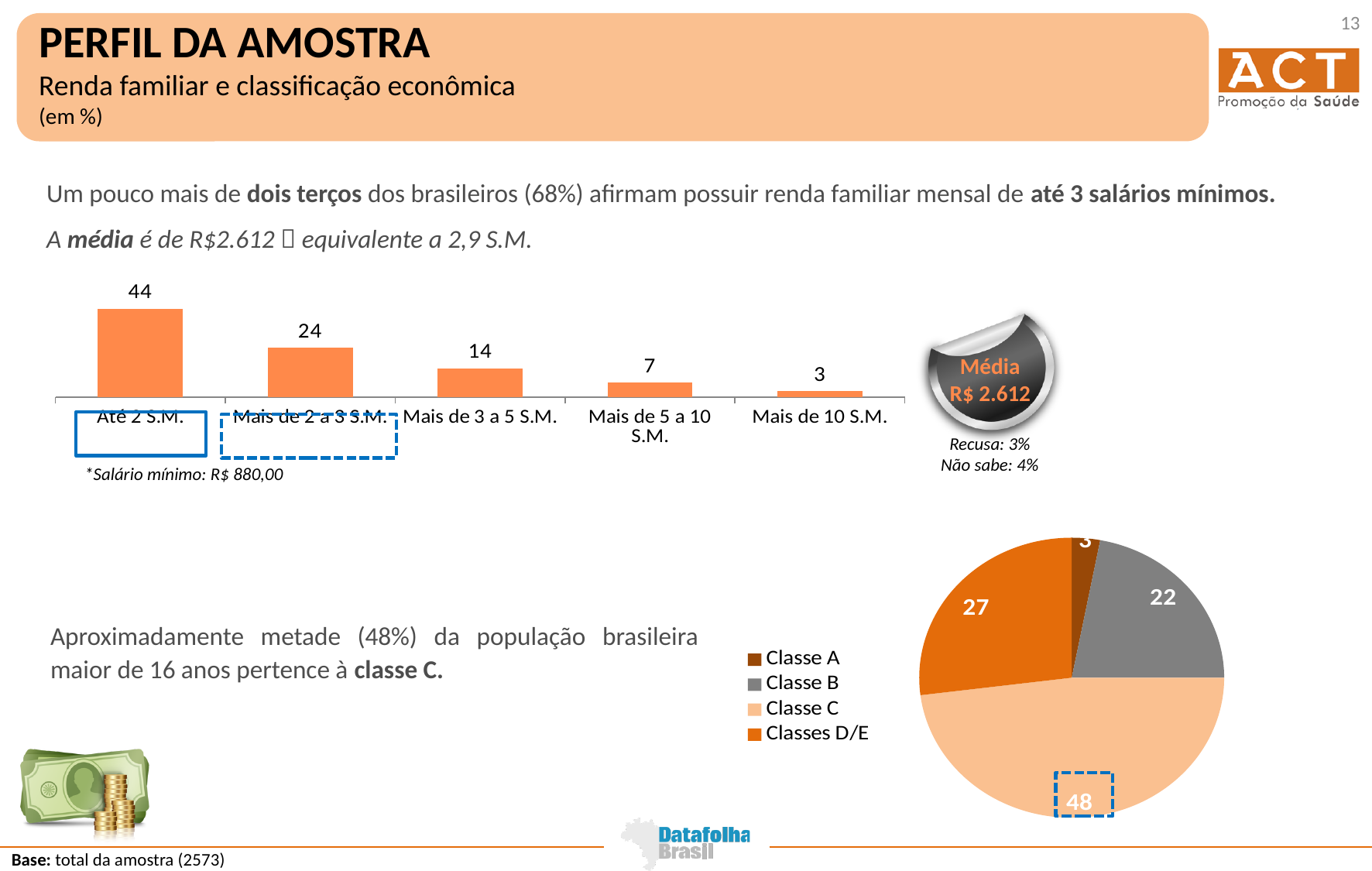
In the bar chart of family income, what is the value for 'Até 2 S.M.'? 44 How many entries does the legend of the pie chart list? 4 In the pie chart of economic classes, which is larger: Classe B or Classes D/E? Classes D/E In the bar chart of family income, which category has the highest value? Até 2 S.M. In the pie chart of economic classes, what is the value for Classe B? 22 What kind of chart is the chart at the bottom right showing economic classes? pie chart In the pie chart of economic classes, which class has the largest slice? Classe C In the bar chart of family income, what is the difference between 'Até 2 S.M.' and 'Mais de 2 a 3 S.M.'? 20 In the bar chart of family income, what is the value for 'Mais de 3 a 5 S.M.'? 14 In the bar chart of family income, which category has the lowest value? Mais de 10 S.M. In the bar chart of family income, do the values rise or fall from left to right? fall In the bar chart of family income, how many categories are shown? 5